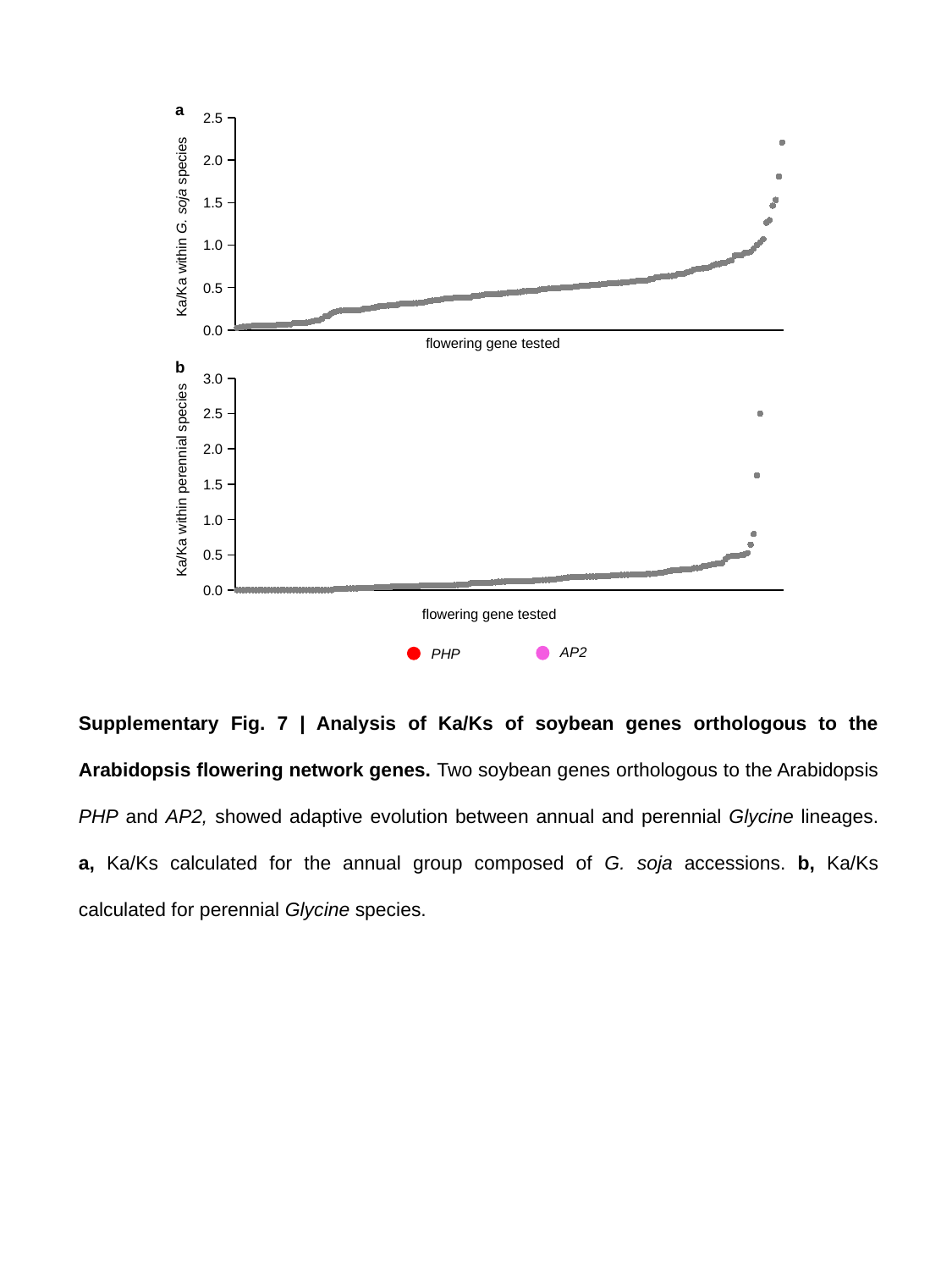
What is the highest tick value on the y axis of chart b (Ka/Ka within perennial species)? 3.0 In chart a (Ka/Ka within G. soja species), is the lowest plotted value greater or less than 0.5? less In chart b (Ka/Ka within perennial species), is the second-highest plotted value greater or less than 1.0? greater In chart a (Ka/Ka within G. soja species), do the plotted values rise or fall from left to right along the x axis? rise What is the highest tick value on the y axis of chart a (Ka/Ka within G. soja species)? 2.5 In chart b (Ka/Ka within perennial species), is the highest plotted value greater or less than 2.0? greater In chart b (Ka/Ka within perennial species), do the plotted values rise or fall from left to right along the x axis? rise What kind of chart is chart b (Ka/Ka within perennial species)? scatter chart Which two gene names are listed in the legend below the charts? PHP and AP2 What is the x-axis label of chart a (Ka/Ka within G. soja species)? flowering gene tested What kind of chart is chart a (Ka/Ka within G. soja species)? scatter chart